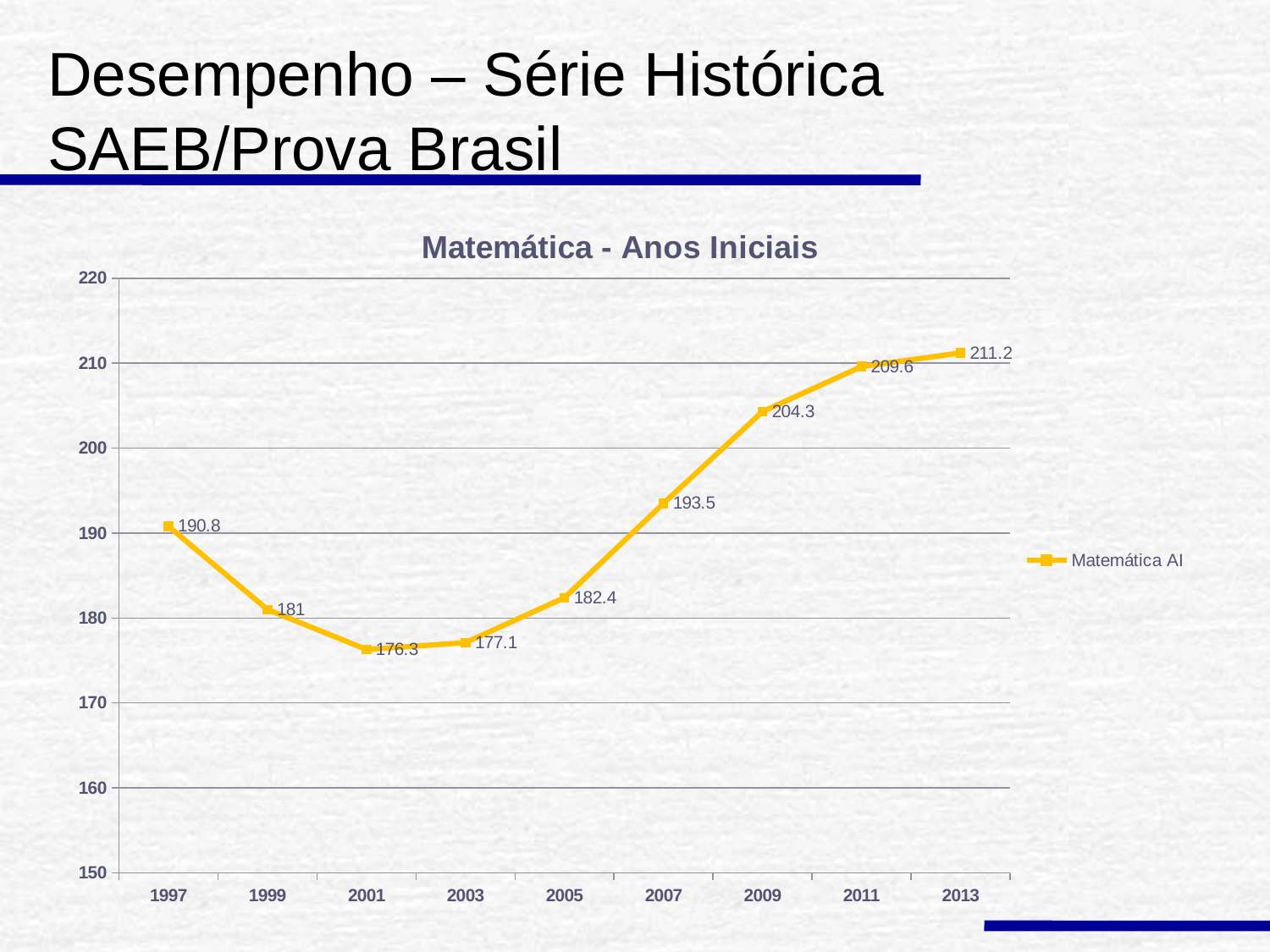
Which is larger, the value for 1999 or the value for 2005? 2005 What is the difference between the values for 2013 and 1997? 20.4 Is the value for 2007 greater or less than 190? greater What is the value for 1997? 190.8 Which year has the highest value? 2013 Which year has the lowest value? 2001 What is the value for 2009? 204.3 Do the values rise or fall from 2003 to 2013? rise How many years are plotted on the chart? 9 What kind of chart is shown? line chart How many series does the legend list? 1 What is the value for 2003? 177.1